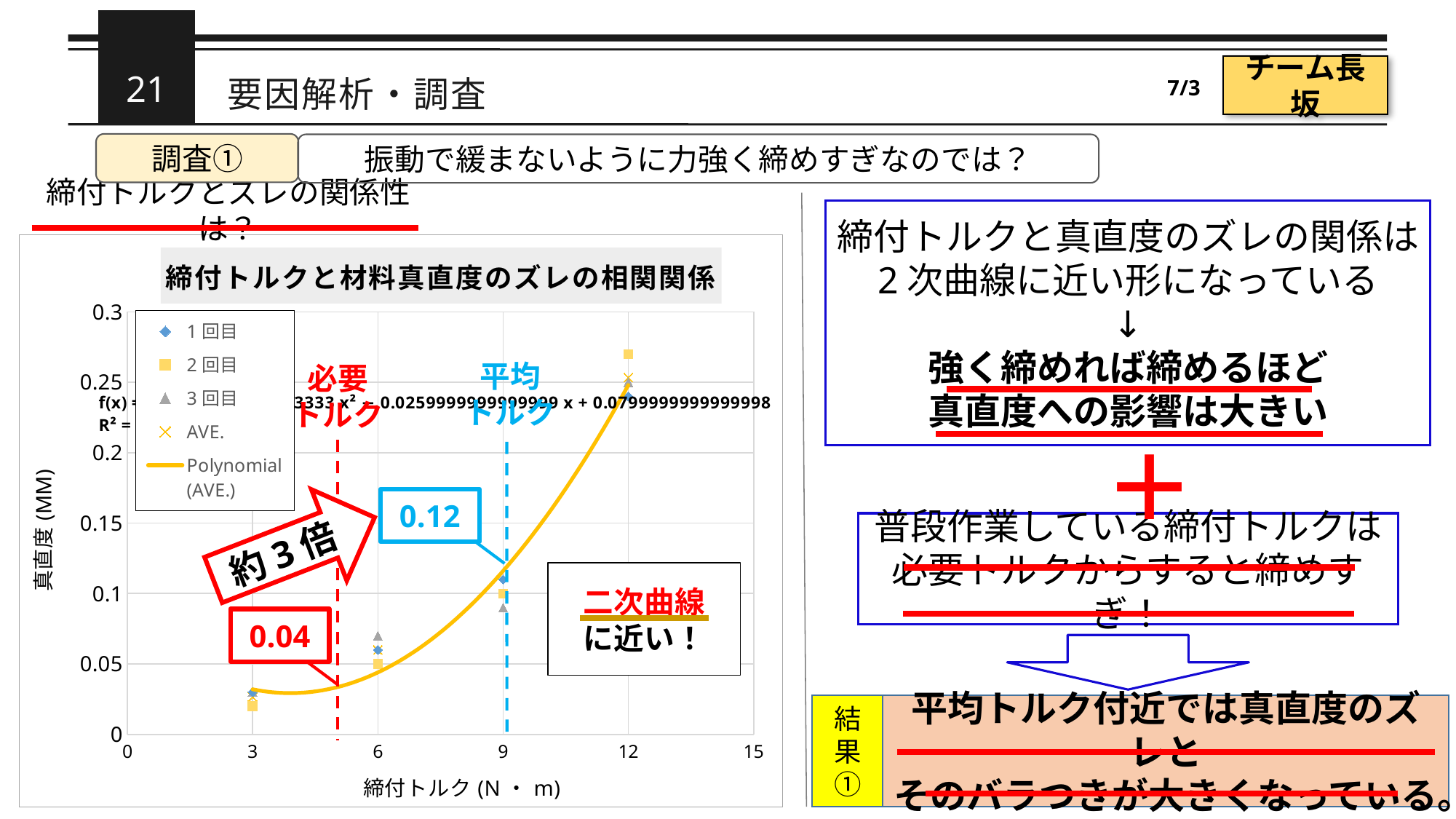
At how many torque values are data points plotted in the chart? 4 At which tightening torque are the plotted 真直度 values highest? 12 Is the AVE. value at a tightening torque of 3 greater or less than 0.05? less What is the label of the x axis of the chart? 締付トルク (N・m) What is the title of the chart? 締付トルクと材料真直度のズレの相関関係 Is the AVE. value at a tightening torque of 9 greater or less than 0.05? greater At which tightening torque are the plotted 真直度 values lowest? 3 What kind of chart is shown on the slide? scatter chart Is the AVE. value at a tightening torque of 12 greater or less than 0.2? greater Which is larger, the AVE. value at a tightening torque of 12 or at a tightening torque of 6? 12 Do the plotted values rise or fall as the tightening torque increases along the x axis? rise How many entries does the chart legend list? 5